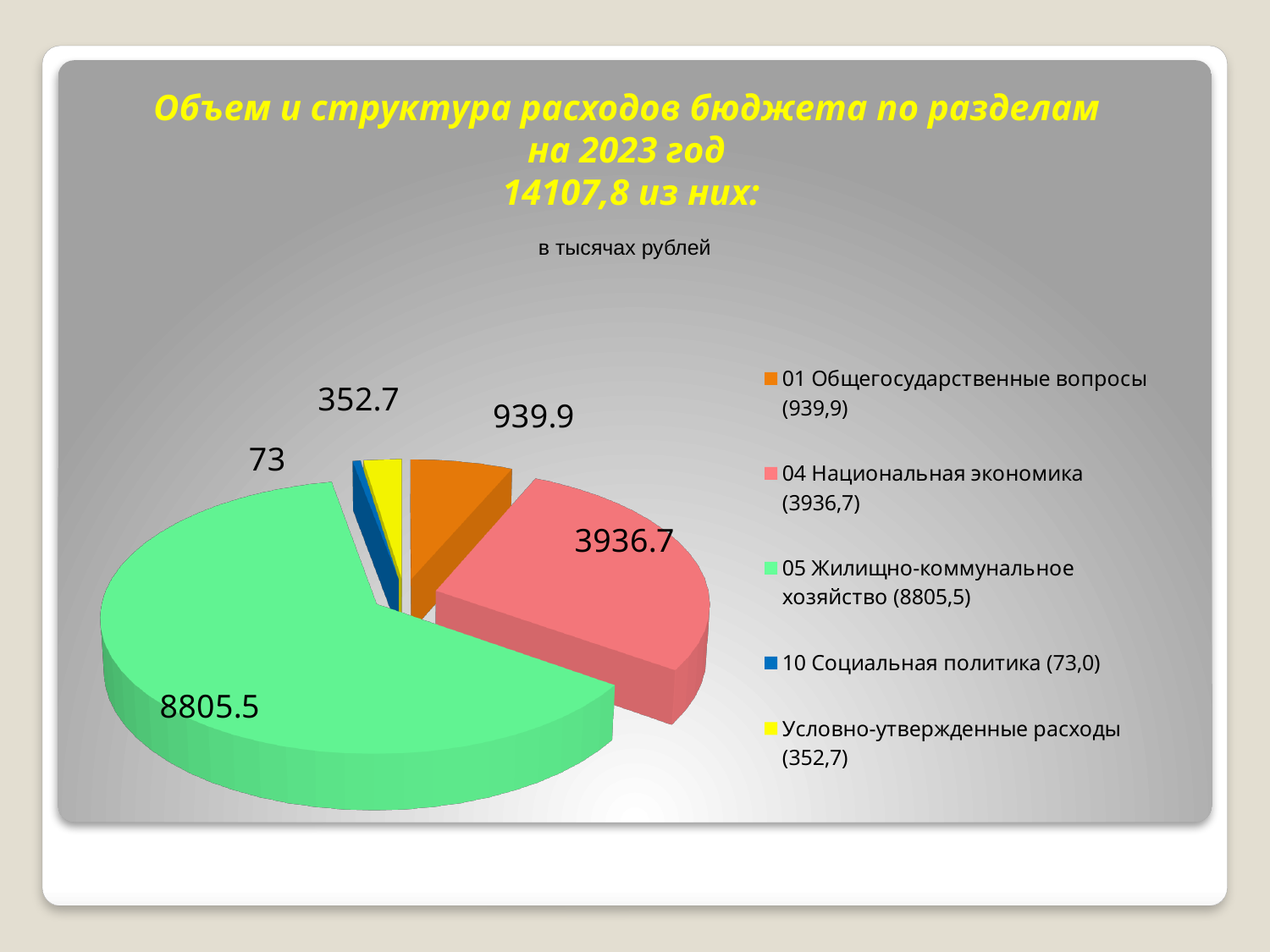
Which category has the smallest slice of the pie? 10 Социальная политика What colour is the slice for 04 Национальная экономика? pink How many slices does the pie chart have? 5 What is the value for 05 Жилищно-коммунальное хозяйство? 8805.5 What is the value for 10 Социальная политика? 73 What is the value for Условно-утвержденные расходы? 352.7 What is the value for 04 Национальная экономика? 3936.7 What is the difference between the values for 05 Жилищно-коммунальное хозяйство and 04 Национальная экономика? 4868.8 Which category has the largest slice of the pie? 05 Жилищно-коммунальное хозяйство Which is larger, the value for 01 Общегосударственные вопросы or the value for Условно-утвержденные расходы? 01 Общегосударственные вопросы What is the total of all the slices in the pie chart? 14107.8 What kind of chart is shown on the slide? pie chart